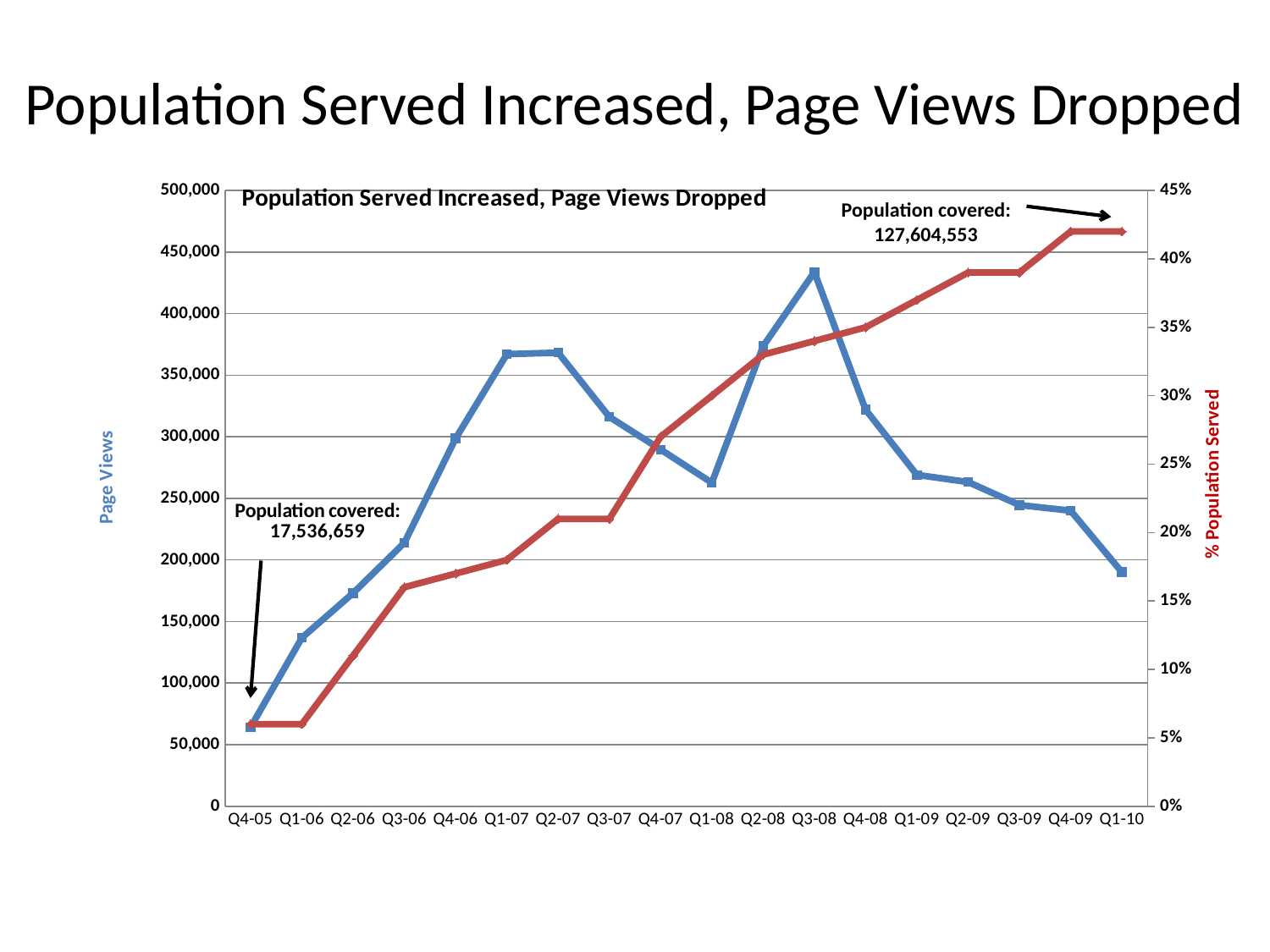
In which quarter are Page Views at their lowest? Q4-05 Which quarter has higher Page Views, Q1-07 or Q3-07? Q1-07 Are Page Views in Q1-10 greater or less than 250,000? less Are Page Views in Q3-08 greater or less than 400,000? greater Is the % Population Served in Q1-10 greater or less than 40%? greater In which quarter do Page Views reach their highest point? Q3-08 What population covered figure is annotated at the start of the series (Q4-05)? 17,536,659 What kind of chart is shown on the slide? Line chart What population covered figure is annotated at the end of the series? 127,604,553 Does the % Population Served line generally rise or fall from Q4-05 to Q1-10? Rise How many quarters are plotted along the x axis? 18